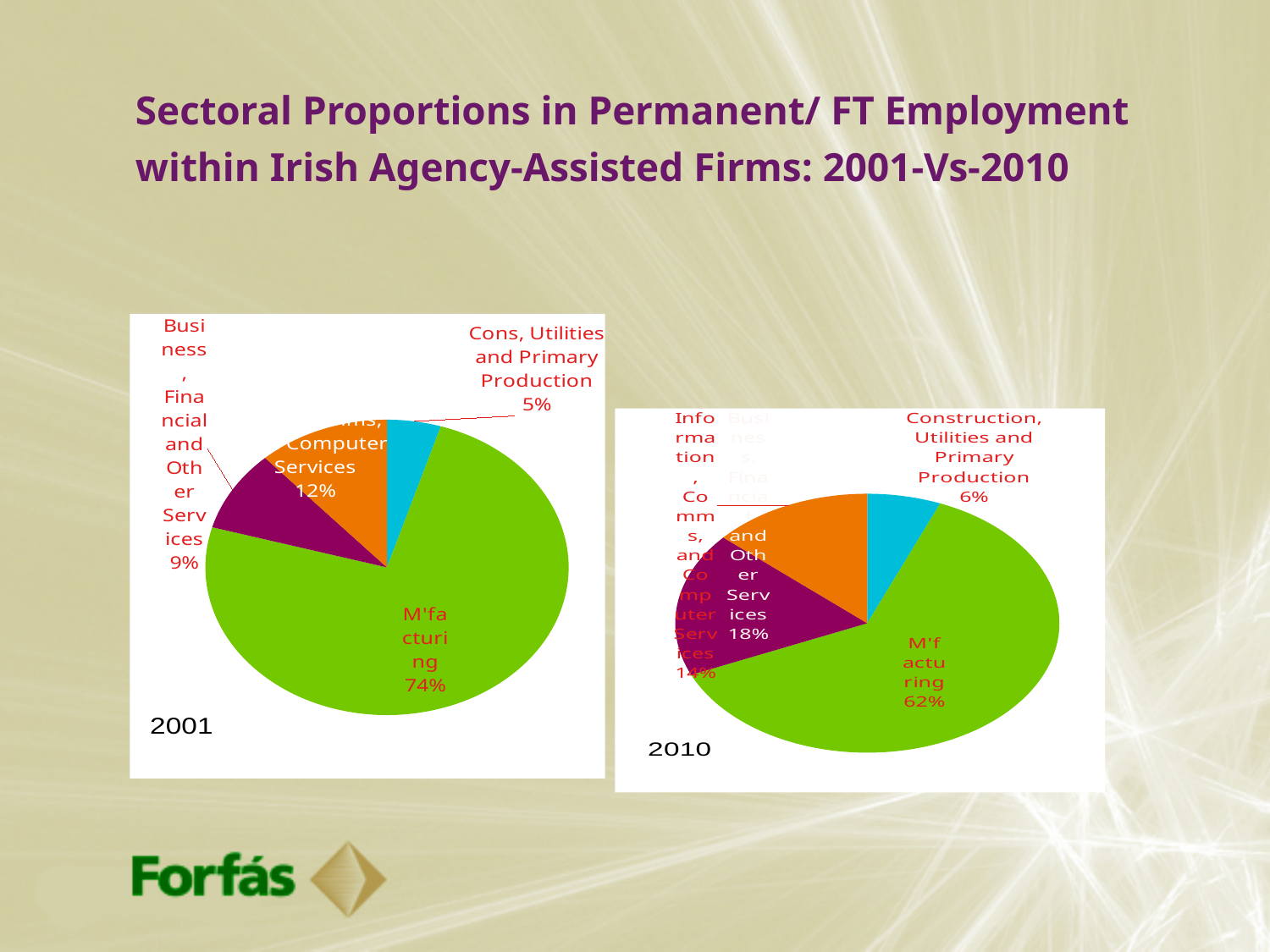
In the 2010 pie chart, what is the share for Construction, Utilities and Primary Production? 6% In the 2010 pie chart, what is the share for Business, Financial and Other Services? 18% In the 2010 pie chart, what share does Manufacturing (M'facturing) hold? 62% In the 2001 pie chart, which sector has the largest share? M'facturing In the 2001 pie chart, what is the share for Cons, Utilities and Primary Production? 5% What type of chart is used for the 2001 and 2010 data on this slide? Pie chart In the 2001 pie chart, what is the share for Business, Financial and Other Services? 9% By how many percentage points did the Manufacturing share fall from the 2001 chart to the 2010 chart? 12 percentage points How many slices does the 2010 pie chart have? 4 In the 2001 pie chart, what share does Manufacturing (M'facturing) hold? 74% In the 2010 pie chart, which sector has the smallest share? Construction, Utilities and Primary Production Which is larger: the Business, Financial and Other Services share in 2001 or in 2010? 2010